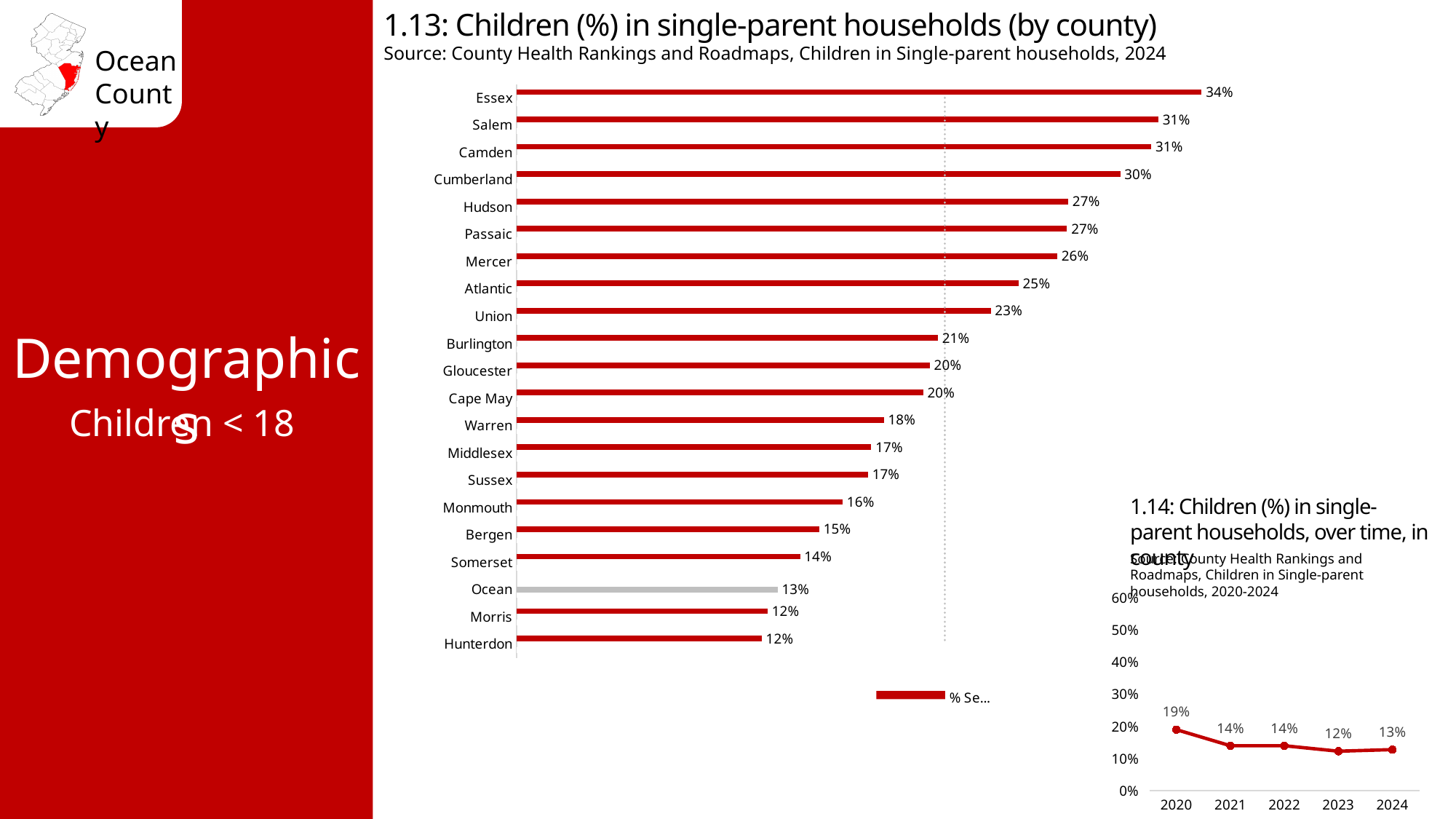
What kind of chart is '1.13: Children (%) in single-parent households (by county)'? Bar chart In the chart '1.13: Children (%) in single-parent households (by county)', what is the value for Essex? 34% In the chart '1.13: Children (%) in single-parent households (by county)', what is the value for Cumberland? 30% In the chart '1.13: Children (%) in single-parent households (by county)', how many counties are shown? 21 In the chart '1.13: Children (%) in single-parent households (by county)', what is the difference between Essex and Ocean? 21% In the chart '1.14: Children (%) in single-parent households, over time, in county', what is the value for 2020? 19% In the chart '1.13: Children (%) in single-parent households (by county)', which county has the highest value? Essex In the chart '1.14: Children (%) in single-parent households, over time, in county', how many data points are plotted? 5 In the chart '1.14: Children (%) in single-parent households, over time, in county', what is the difference between the 2020 and 2024 values? 6% In the chart '1.13: Children (%) in single-parent households (by county)', which is larger, Hudson or Monmouth? Hudson In the chart '1.14: Children (%) in single-parent households, over time, in county', which year has the lowest value? 2023 In the chart '1.13: Children (%) in single-parent households (by county)', what is the value for Ocean? 13%